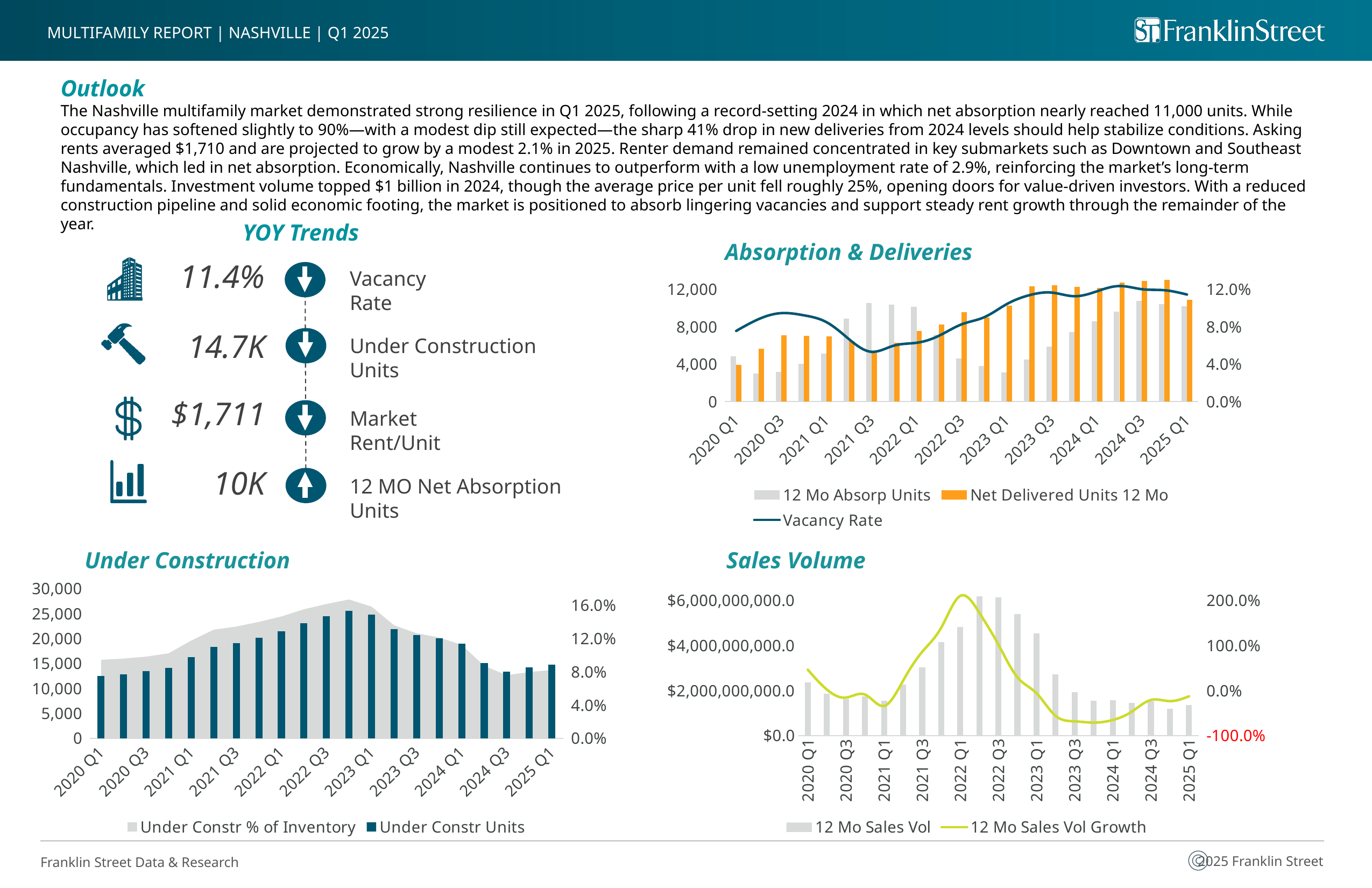
In the Sales Volume chart, is the 12 Mo Sales Vol Growth for 2023 Q3 greater or less than 0.0%? less In the Absorption & Deliveries chart, which is larger for 2023 Q3: 12 Mo Absorp Units or Net Delivered Units 12 Mo? Net Delivered Units 12 Mo In the Sales Volume chart, is the 12 Mo Sales Vol for 2022 Q1 greater or less than $4,000,000,000.0? greater In the Under Construction chart, do the Under Constr Units bars rise or fall from 2023 Q1 to 2024 Q3? fall What kind of chart is the Sales Volume chart? Combined bar and line chart In the Absorption & Deliveries chart, is the 12 Mo Absorp Units value for 2021 Q3 greater or less than 8,000? greater How many series does the legend of the Under Construction chart list? 2 In the Absorption & Deliveries chart, which series is drawn in orange? Net Delivered Units 12 Mo How many series does the legend of the Absorption & Deliveries chart list? 3